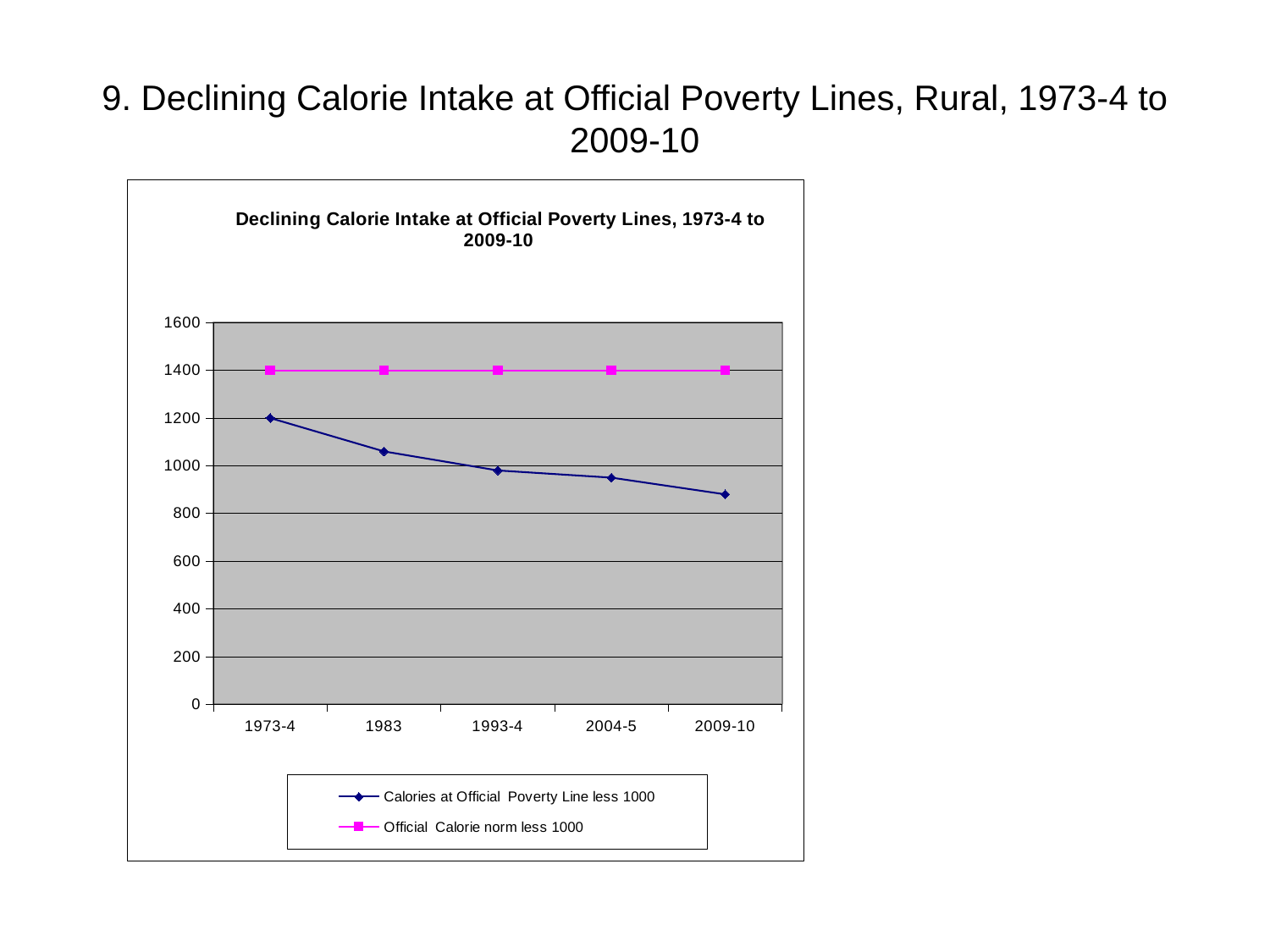
Does the Calories at Official Poverty Line less 1000 series rise or fall from 1973-4 to 2009-10? fall What is the value of Calories at Official Poverty Line less 1000 in 1973-4? 1200 What is the value of the Official Calorie norm less 1000 series in 1983? 1400 What kind of chart is shown on the slide? line chart How many points are plotted along the x axis for each series? 5 In which year is the Calories at Official Poverty Line less 1000 series at its lowest? 2009-10 How many series does the legend list? 2 Which series has the higher value in 1993-4, Calories at Official Poverty Line less 1000 or Official Calorie norm less 1000? Official Calorie norm less 1000 Is the value for Calories at Official Poverty Line less 1000 in 1983 greater or less than 1000? greater What is the title of the chart? Declining Calorie Intake at Official Poverty Lines, 1973-4 to 2009-10 Is the value for Calories at Official Poverty Line less 1000 in 2004-5 greater or less than 800? greater Is the value for Calories at Official Poverty Line less 1000 in 2009-10 greater or less than 1000? less